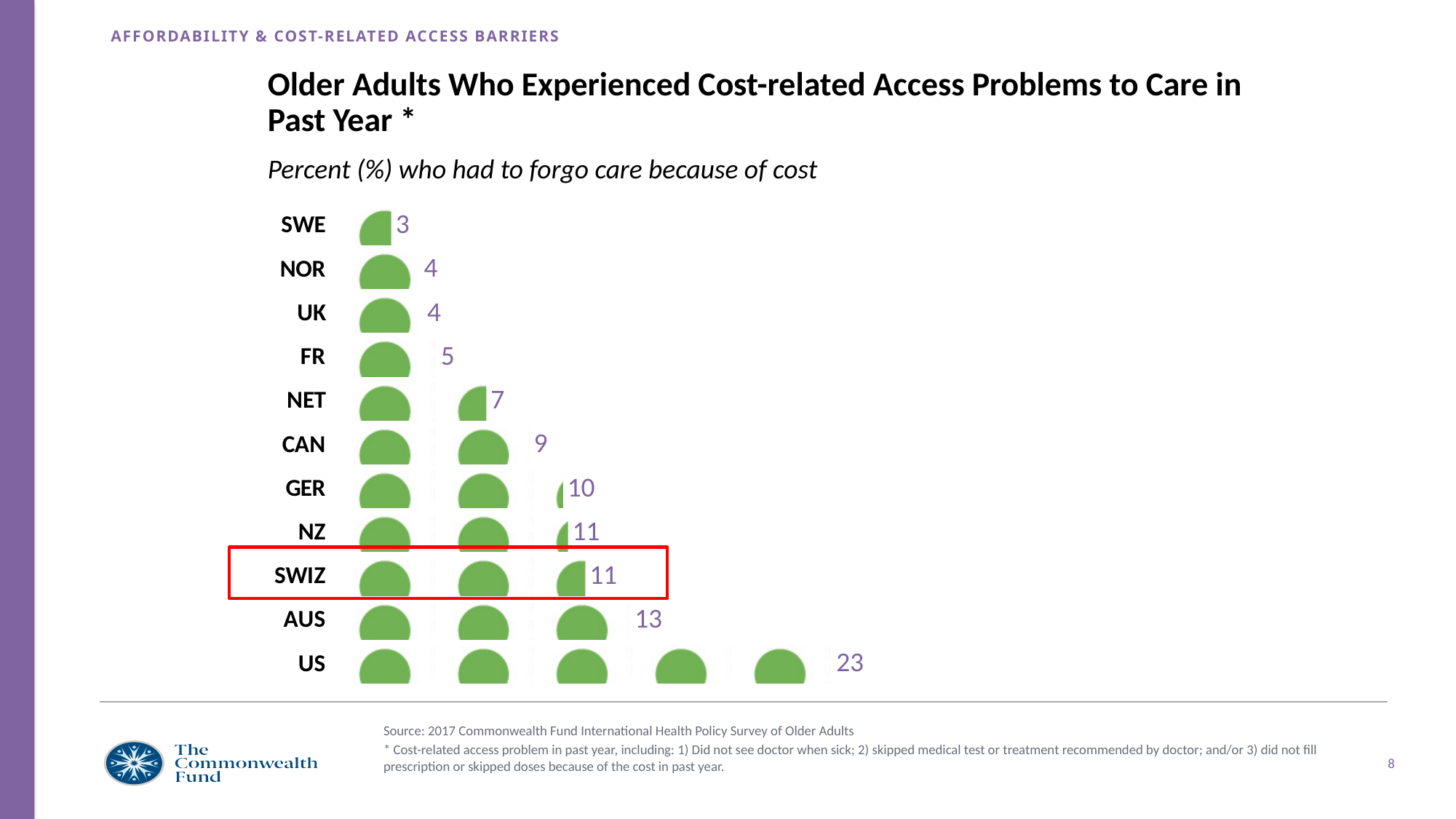
What is the value for NET? 7 What is the value for SWIZ? 11 Which has a larger value, AUS or NZ? AUS Which country has the highest value? US What is the difference between the values for GER and FR? 5 What kind of chart is this? bar chart What is the value for CAN? 9 How many countries are shown in the chart? 11 What is the value for the US? 23 Which country is highlighted with a red box? SWIZ Which country has the lowest value? SWE What is the difference between the values for the US and AUS? 10